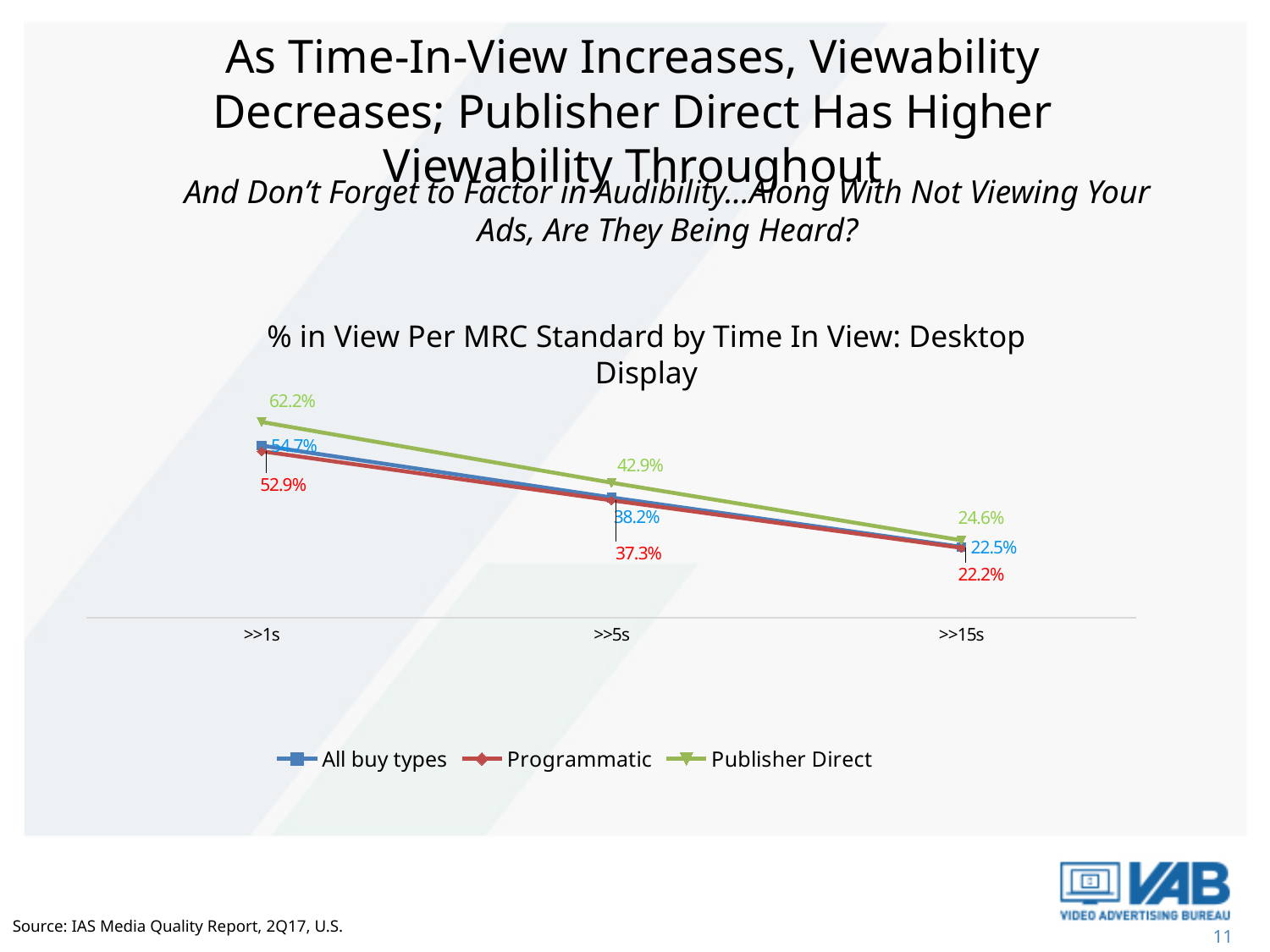
What kind of chart is shown on the slide? Line chart Which series has the lowest value at >>1s? Programmatic What is the value for Programmatic at >>5s? 37.3% What is the value for All buy types at >>15s? 22.5% How many series does the legend list? 3 Which series has the highest value at >>5s? Publisher Direct How many time-in-view categories are shown on the x axis? 3 Which is larger: Publisher Direct at >>5s or All buy types at >>1s? All buy types at >>1s What is the value for Publisher Direct at >>15s? 24.6% What is the value for Publisher Direct at >>1s? 62.2% What is the difference between Publisher Direct and Programmatic at >>1s? 9.3% What is the difference between Publisher Direct and All buy types at >>15s? 2.1%